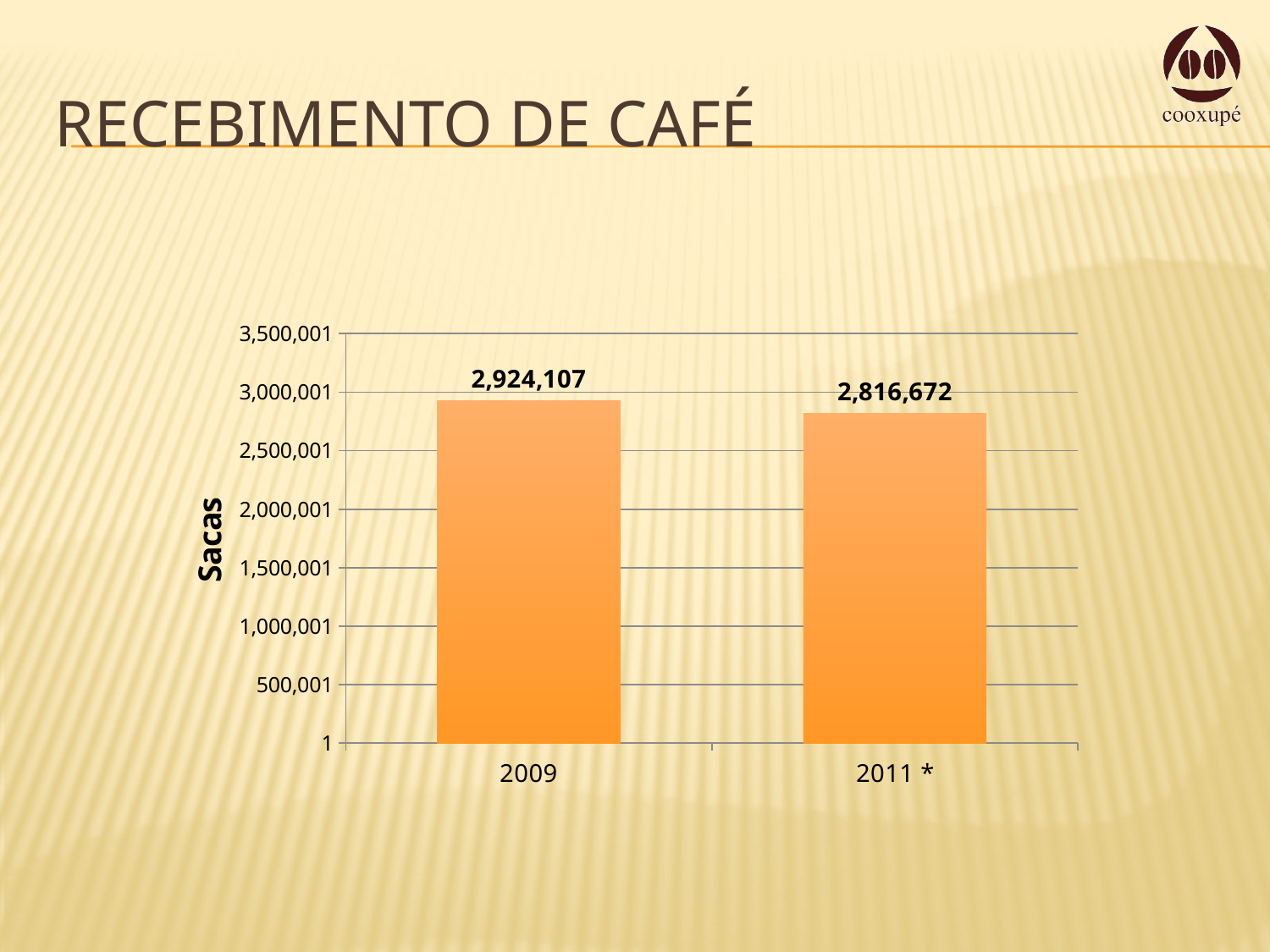
Which year has the highest value? 2009 Which year has the lowest value? 2011 * What is the title of the slide? RECEBIMENTO DE CAFÉ What is the label of the vertical axis? Sacas Is the value for 2011 * greater or less than 3,000,001? less What is the difference between the values for 2009 and 2011 *? 107,435 How many bars are shown in the chart? 2 What kind of chart is shown on the slide? bar chart Do the values rise or fall from 2009 to 2011 *? fall What is the value for 2011 *? 2,816,672 What is the value for 2009? 2,924,107 Which is larger, the value for 2009 or the value for 2011 *? 2009